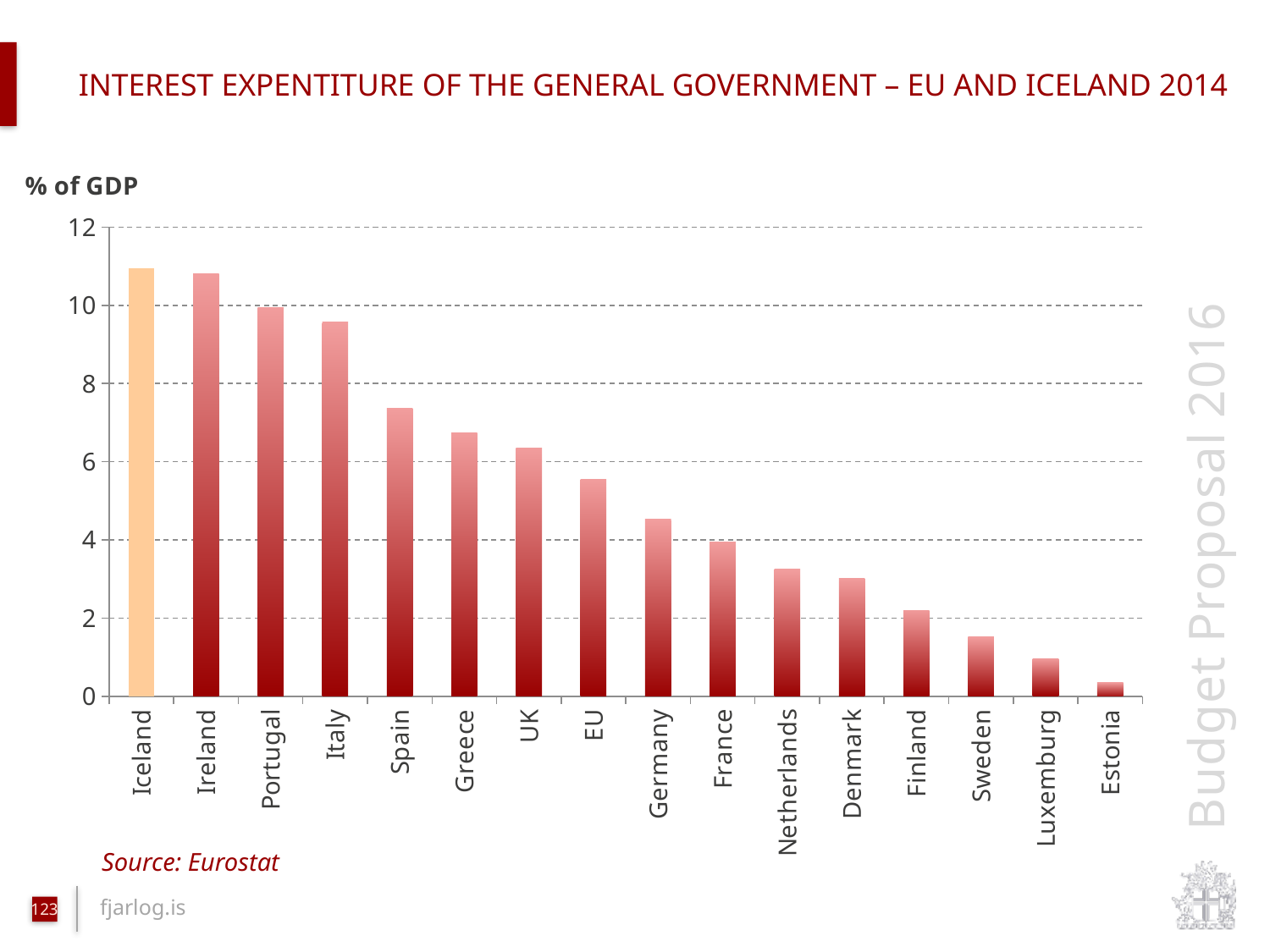
Which has the larger value, Spain or Greece? Spain Is the value for Sweden greater or less than 2? less Is the value for Italy greater or less than 10? less Is the value for Netherlands greater or less than 2? greater What is the source cited for the chart data? Eurostat Do the values rise or fall moving from left to right along the x axis? fall How many countries/categories are shown on the x axis? 16 Which category has the lowest interest expenditure as % of GDP? Estonia What kind of chart is shown on the slide? bar chart